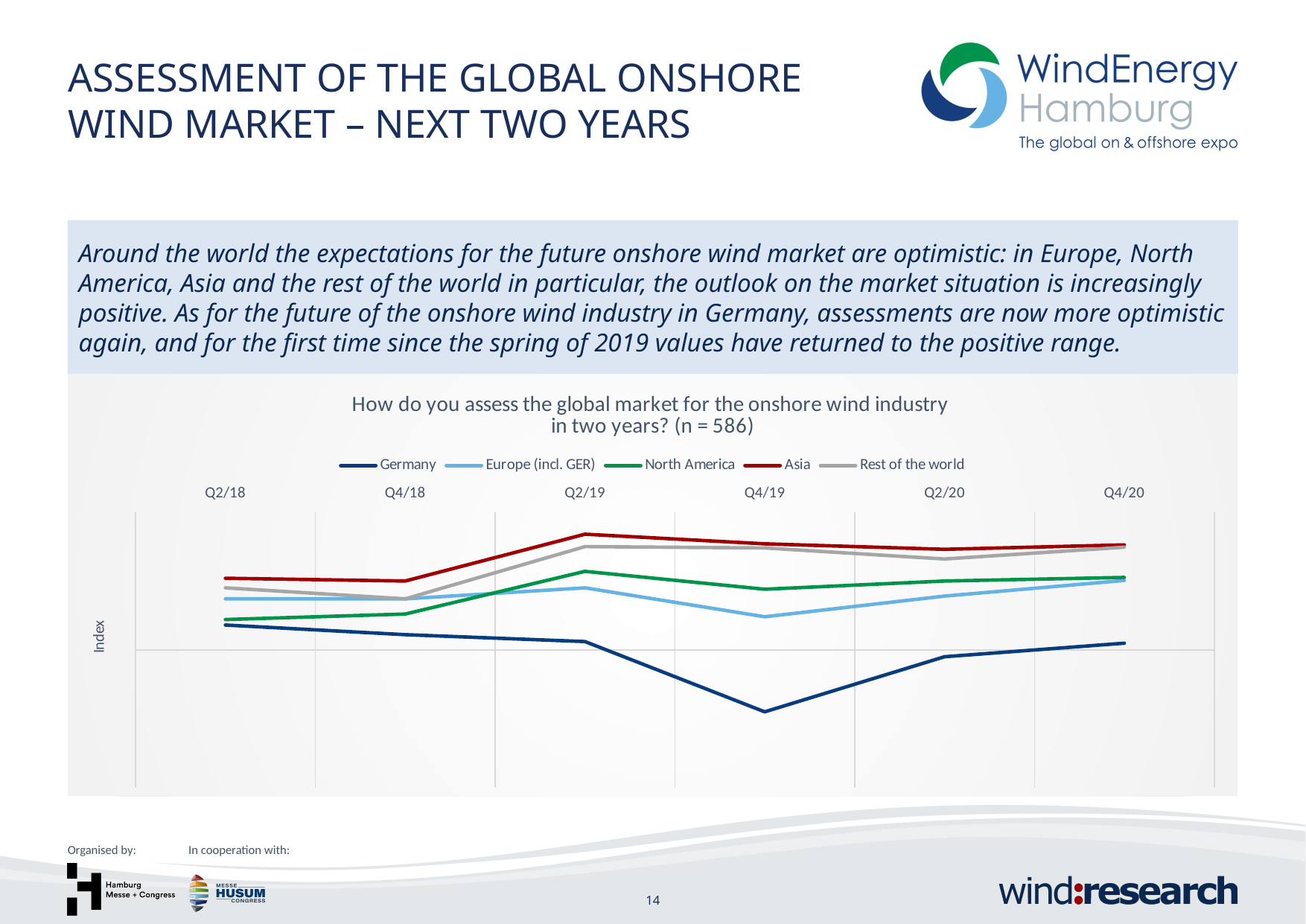
What kind of chart is shown on the slide? line chart How many series does the legend list? 5 Which series has the lowest value at Q4/19? Germany At Q4/19, which is higher: Asia or Germany? Asia At which time point does the Asia series reach its highest value? Q2/19 Does the Germany series rise or fall from Q2/19 to Q4/19? fall At Q2/18, which is higher: Rest of the world or Europe (incl. GER)? Rest of the world Which series has the highest value at Q2/19? Asia What is the sample size (n) given in the chart title? 586 At which time point does the Germany series reach its lowest value? Q4/19 How many time points are shown on the x axis? 6 Does the Germany series rise or fall from Q4/19 to Q4/20? rise